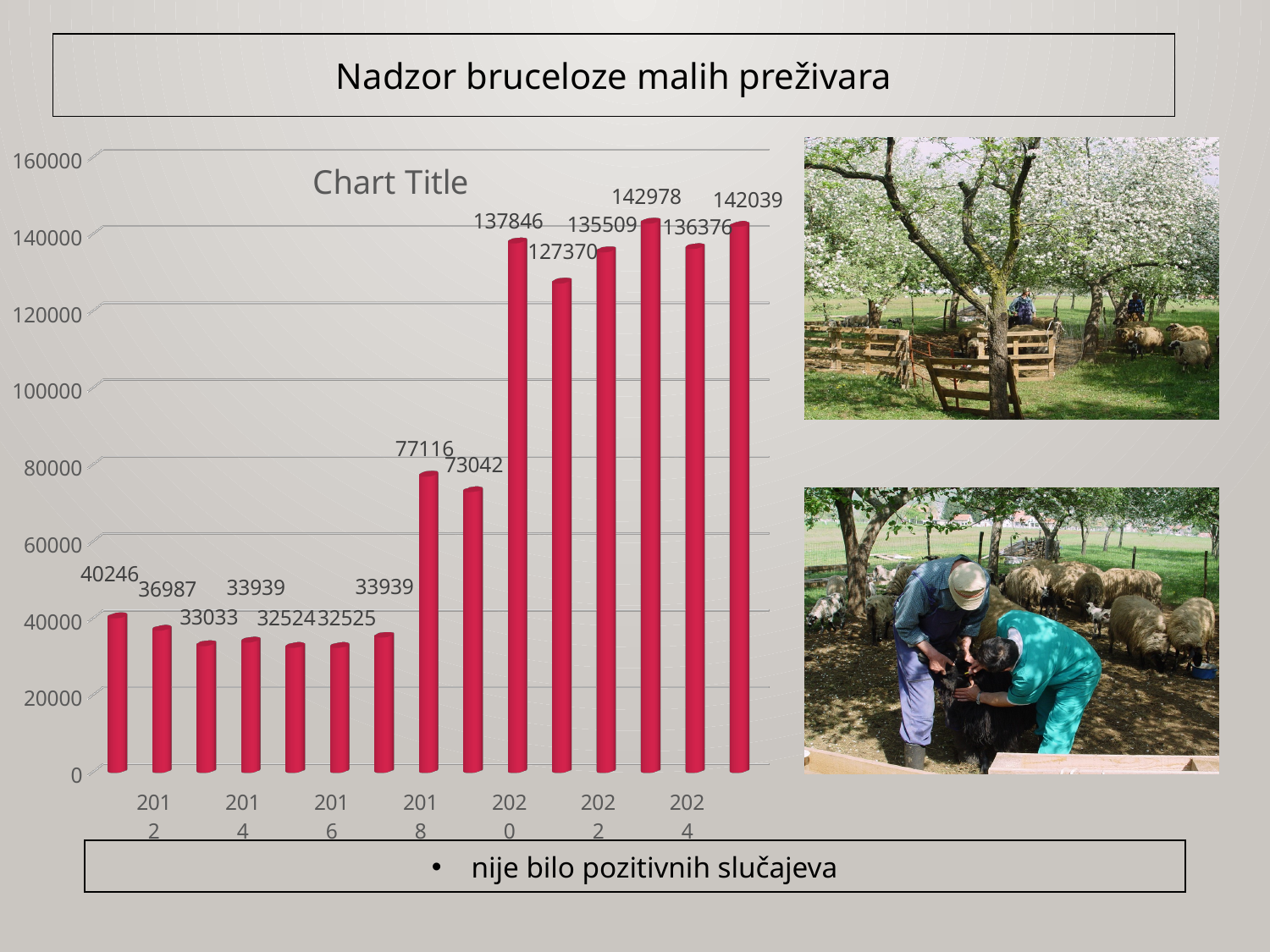
What is the value for 2024? 136376 Which is larger, the value for 2020 or the value for 2022? 2020 What kind of chart is shown on the slide? bar chart What is the title printed on the chart? Chart Title How many bars are plotted in the chart? 15 What is the value for 2020? 137846 What is the highest value shown in the chart? 142978 What is the value for 2012? 36987 What is the value for 2018? 77116 What is the difference between the values for 2018 and 2016? 44591 Is the value for 2014 greater or less than 60000? less What is the difference between the values for 2020 and 2018? 60730